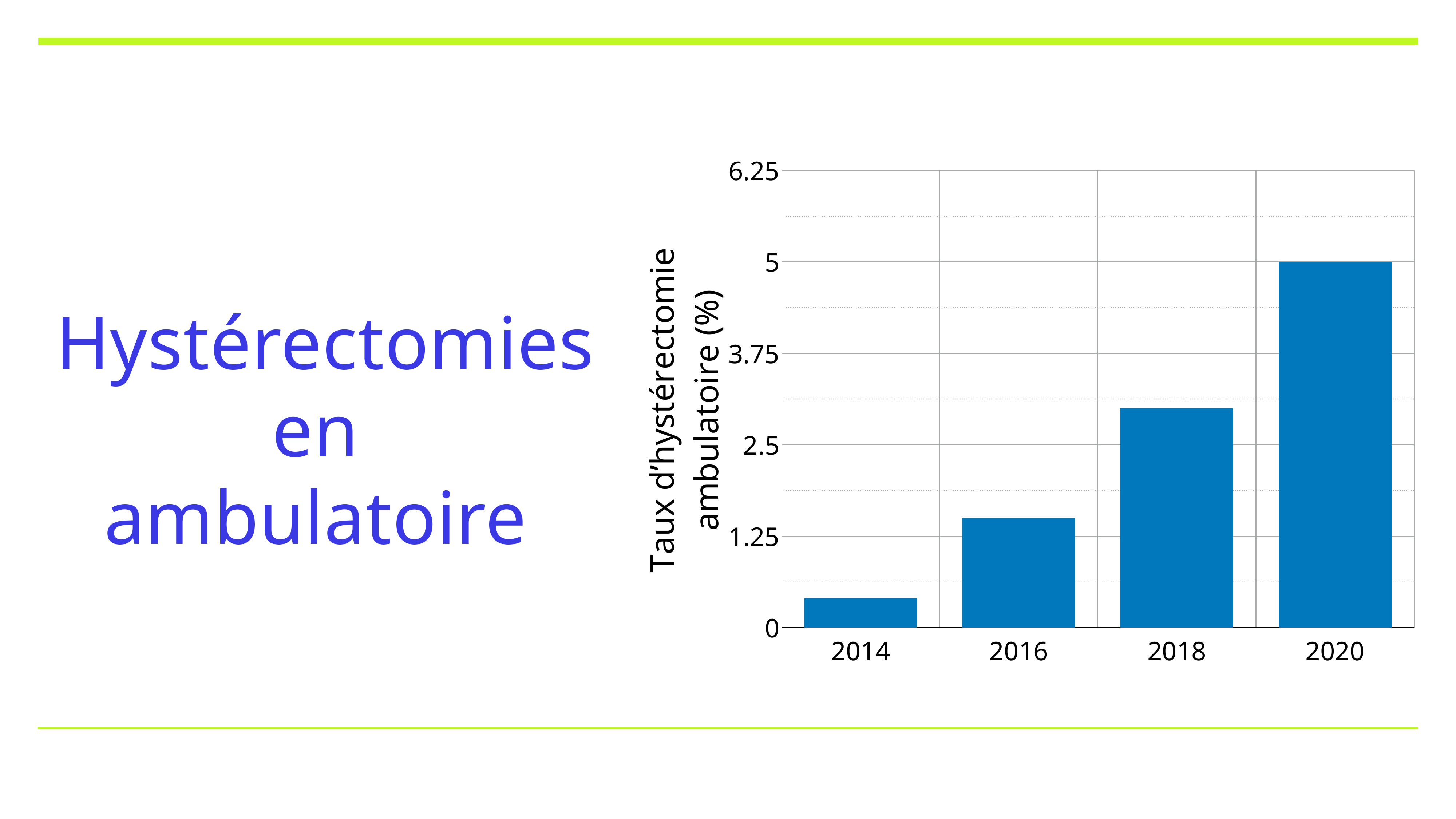
How many bars (years) are plotted in the chart? 4 Which year has the lowest ambulatory hysterectomy rate? 2014 What is the label of the vertical axis? Taux d'hystérectomie ambulatoire (%) Is the value for 2018 greater or less than 3.75? less Is the value for 2014 greater or less than 1.25? less Do the values rise or fall from 2014 to 2020? rise Is the value for 2018 greater or less than 2.5? greater What kind of chart is shown on the slide? bar chart Which year has the highest ambulatory hysterectomy rate? 2020 Which is larger, the value for 2016 or the value for 2018? 2018